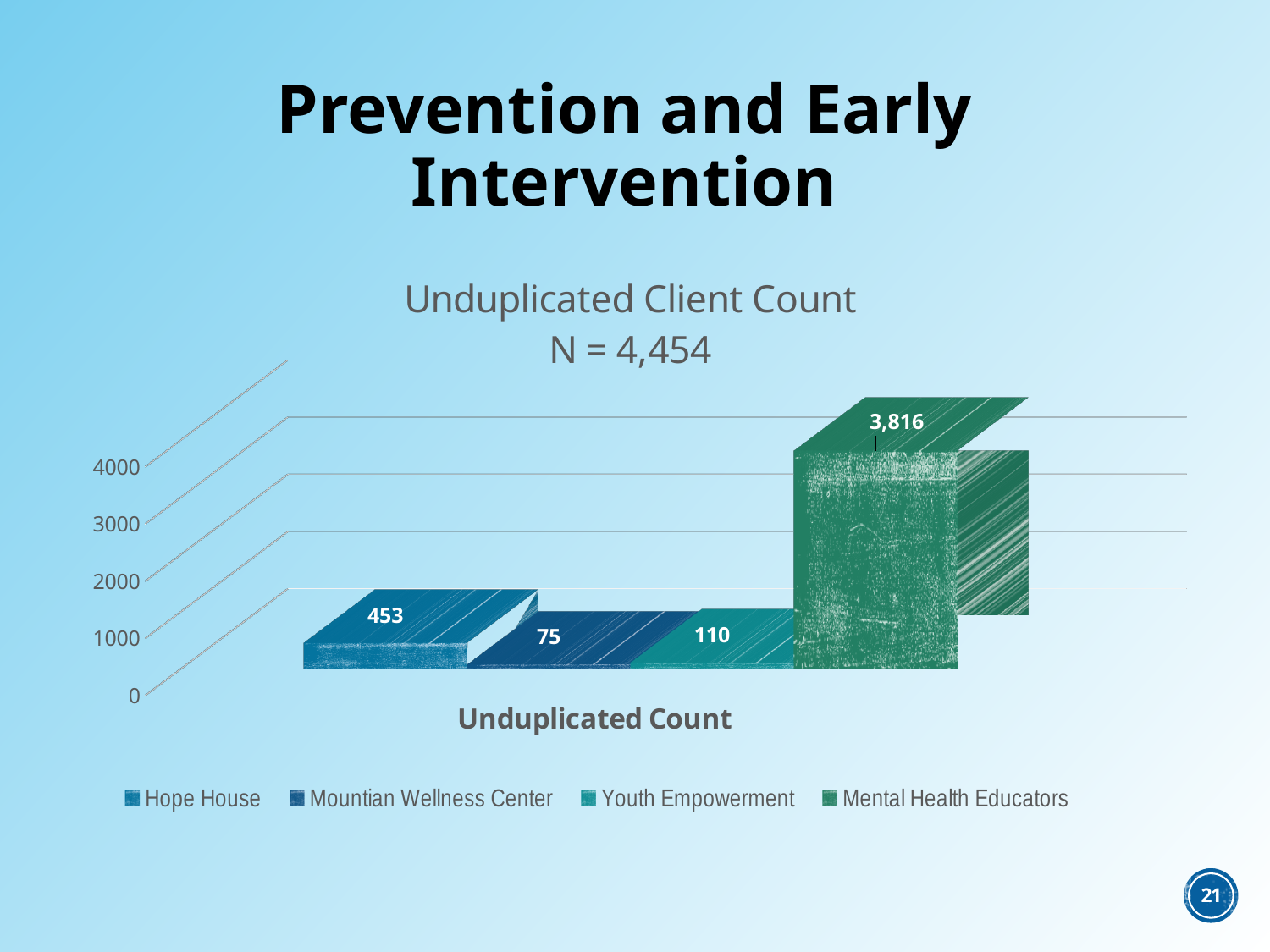
What kind of chart is shown on the slide? Bar chart What is the value for Hope House? 453 Which series has the highest value? Mental Health Educators What is the value for Youth Empowerment? 110 Which series has the lowest value? Mountian Wellness Center What is the difference between the values for Youth Empowerment and Mountian Wellness Center? 35 What is the difference between the values for Mental Health Educators and Hope House? 3,363 What is the value for Mountian Wellness Center? 75 What is the value for Mental Health Educators? 3,816 How many series does the legend list? 4 Which is larger, the value for Hope House or the value for Youth Empowerment? Hope House What is the title of the chart? Unduplicated Client Count N = 4,454